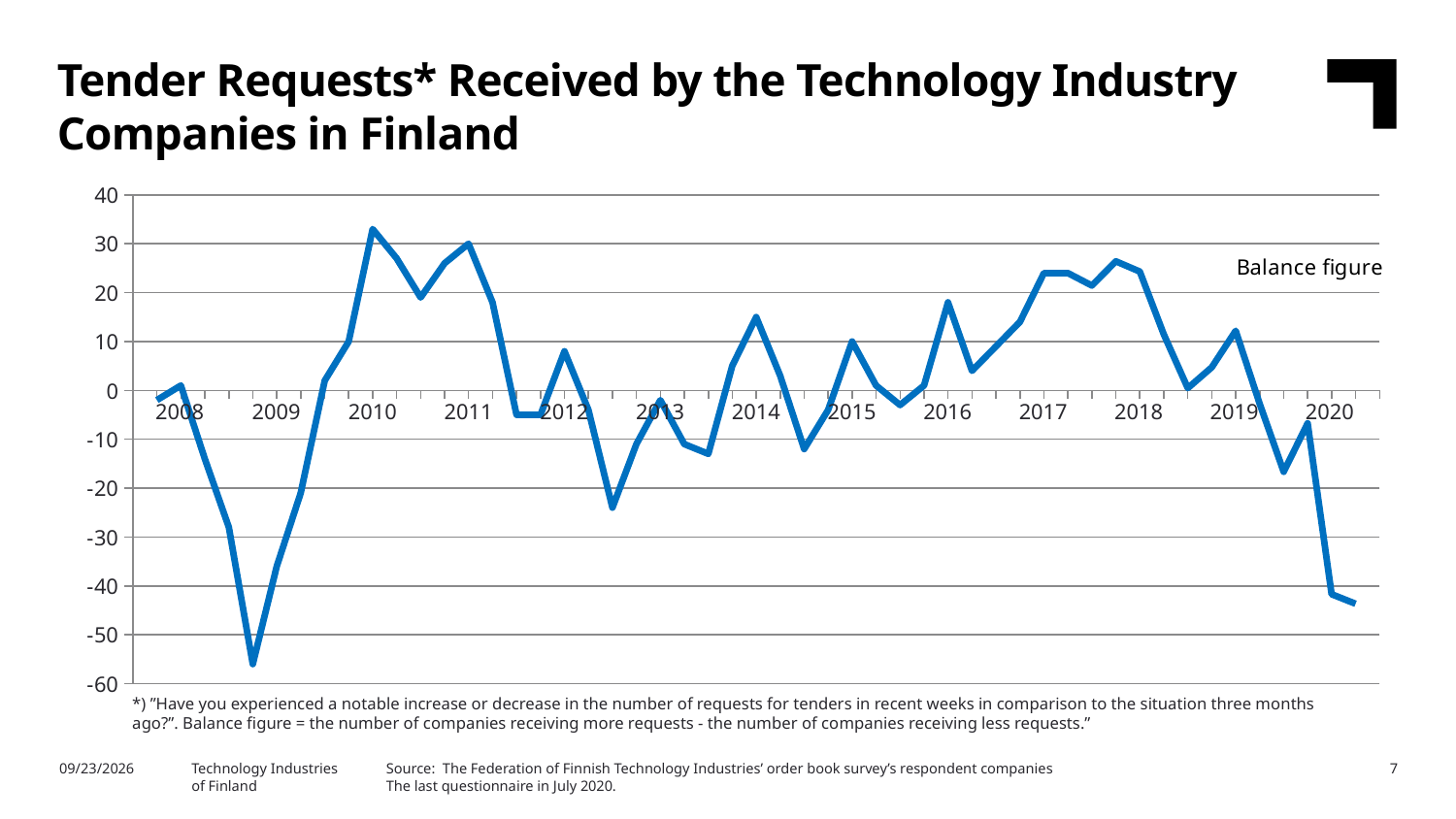
Is the final value in 2020 greater or less than -30? less What label is shown for the plotted series in the chart? Balance figure How many years are labelled on the x axis of the chart? 13 What is the title of the chart? Tender Requests* Received by the Technology Industry Companies in Finland Is the lowest value in 2009 greater or less than -50? less Is the peak value in 2010 greater or less than 30? greater In which year does the line reach its lowest point? 2009 Does the line rise or fall between its 2018 peak and the end of 2020? fall Does the line rise or fall between its 2009 low and its 2010 peak? rise What kind of chart is shown on the slide? Line chart